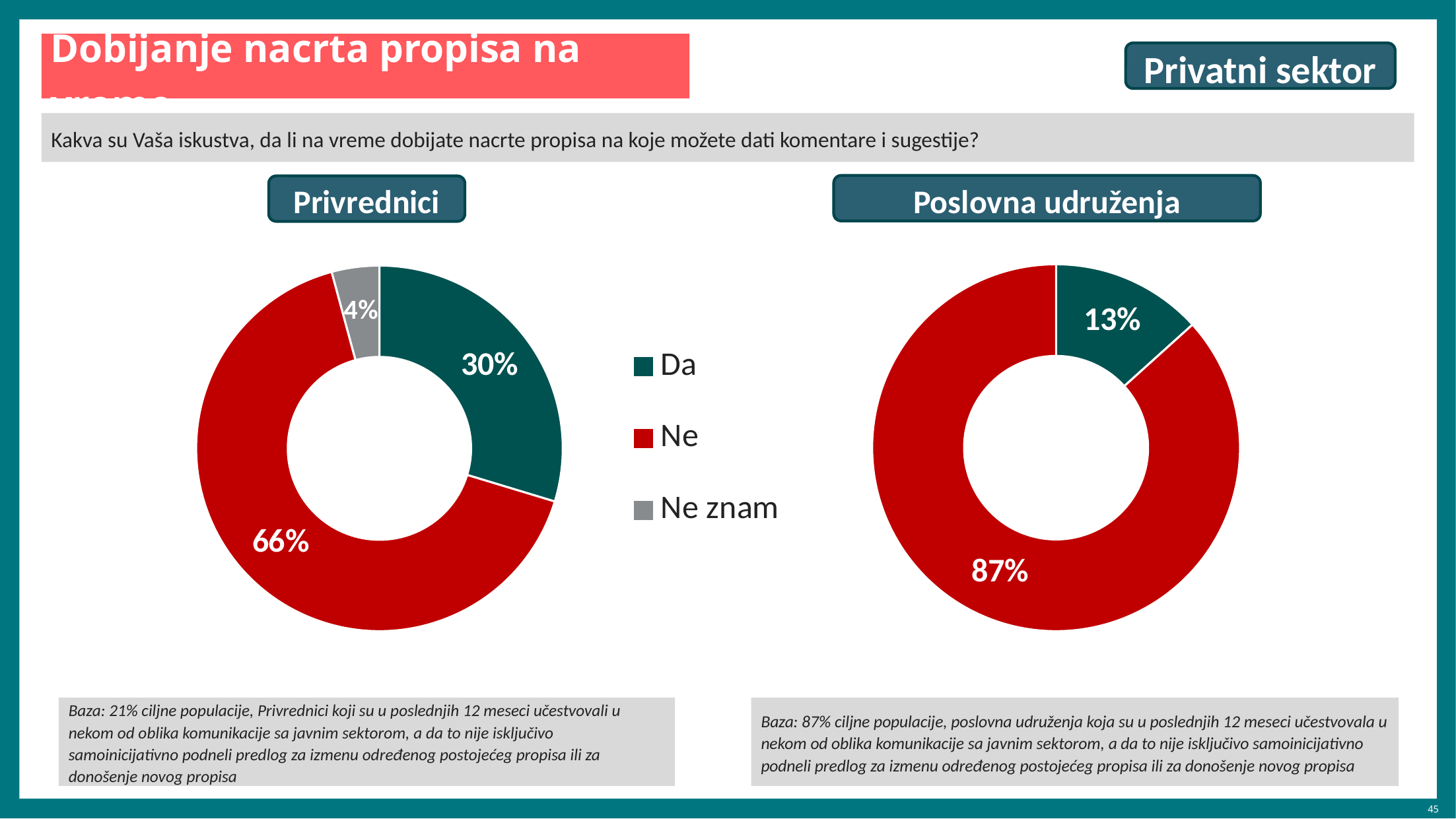
In the Poslovna udruženja chart, which answer has the smallest share? Da In the Poslovna udruženja chart, what percentage answered "Da"? 13% In the Privrednici chart, which answer has the smallest share? Ne znam In the Poslovna udruženja chart, what percentage answered "Ne"? 87% How many entries does the legend between the two charts list? 3 In the Privrednici chart, what is the difference between the "Ne" and "Da" shares? 36 percentage points In the Privrednici chart, which answer has the largest share? Ne What type of chart is used for the Privrednici data? Donut (pie) chart In the Privrednici chart, what percentage answered "Ne"? 66% In the Privrednici chart, what percentage answered "Da"? 30% In the Privrednici chart, what percentage answered "Ne znam"? 4% Which chart has the larger share for "Da", Privrednici or Poslovna udruženja? Privrednici